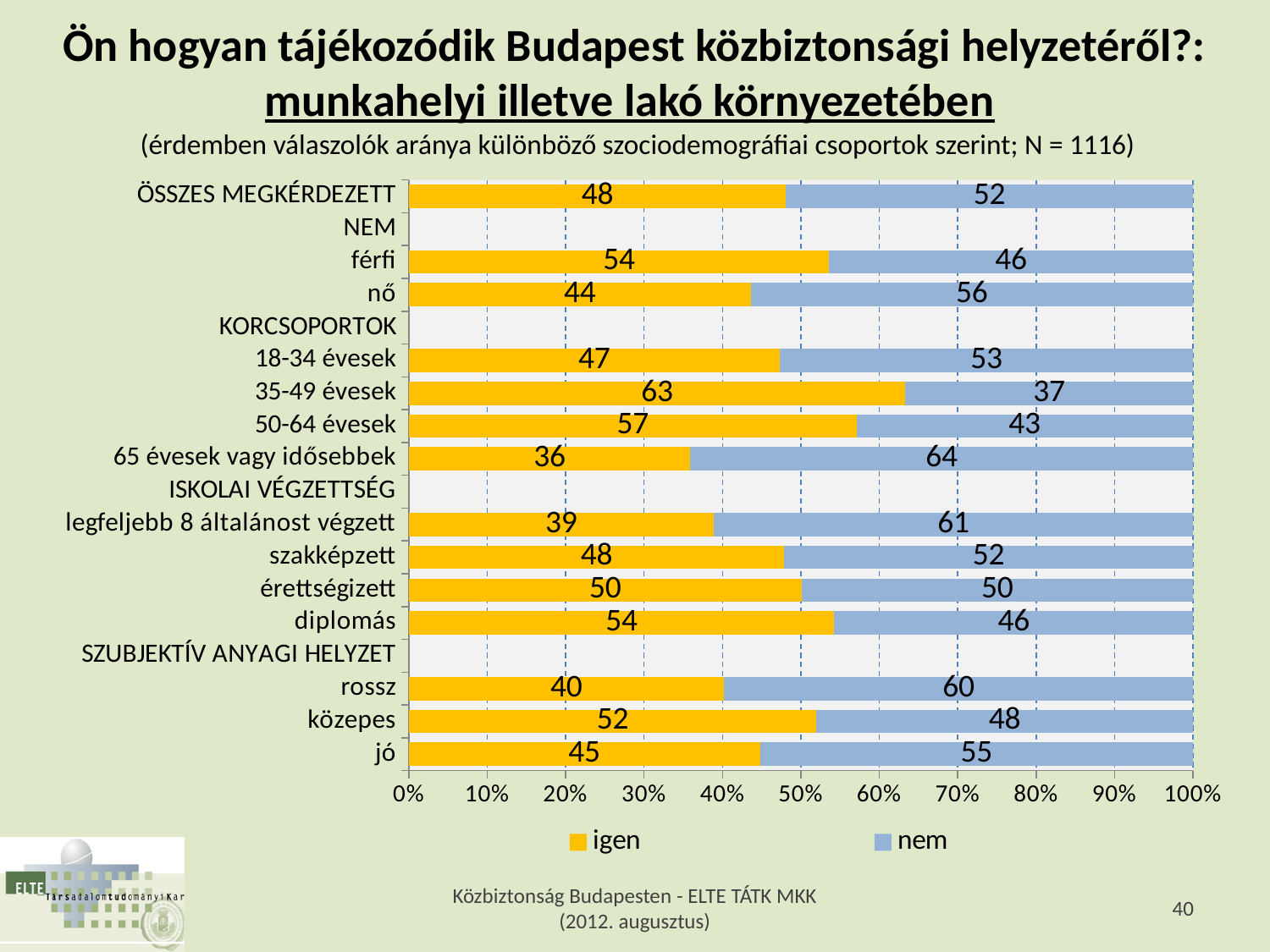
What is the "igen" value for 35-49 évesek? 63 Is the "igen" value for legfeljebb 8 általánost végzett greater or less than 50%? less What is the difference between the "igen" values for férfi and nő? 10 Which colour represents the "nem" series? blue Which has a larger "igen" value, rossz or közepes? közepes What is the "igen" value for ÖSSZES MEGKÉRDEZETT? 48 Which category has the lowest "igen" value? 65 évesek vagy idősebbek How many series does the legend list? 2 What kind of chart is shown on the slide? stacked bar chart What is the total of the stacked bar for diplomás? 100 What is the "nem" value for 65 évesek vagy idősebbek? 64 Which category has the highest "igen" value? 35-49 évesek